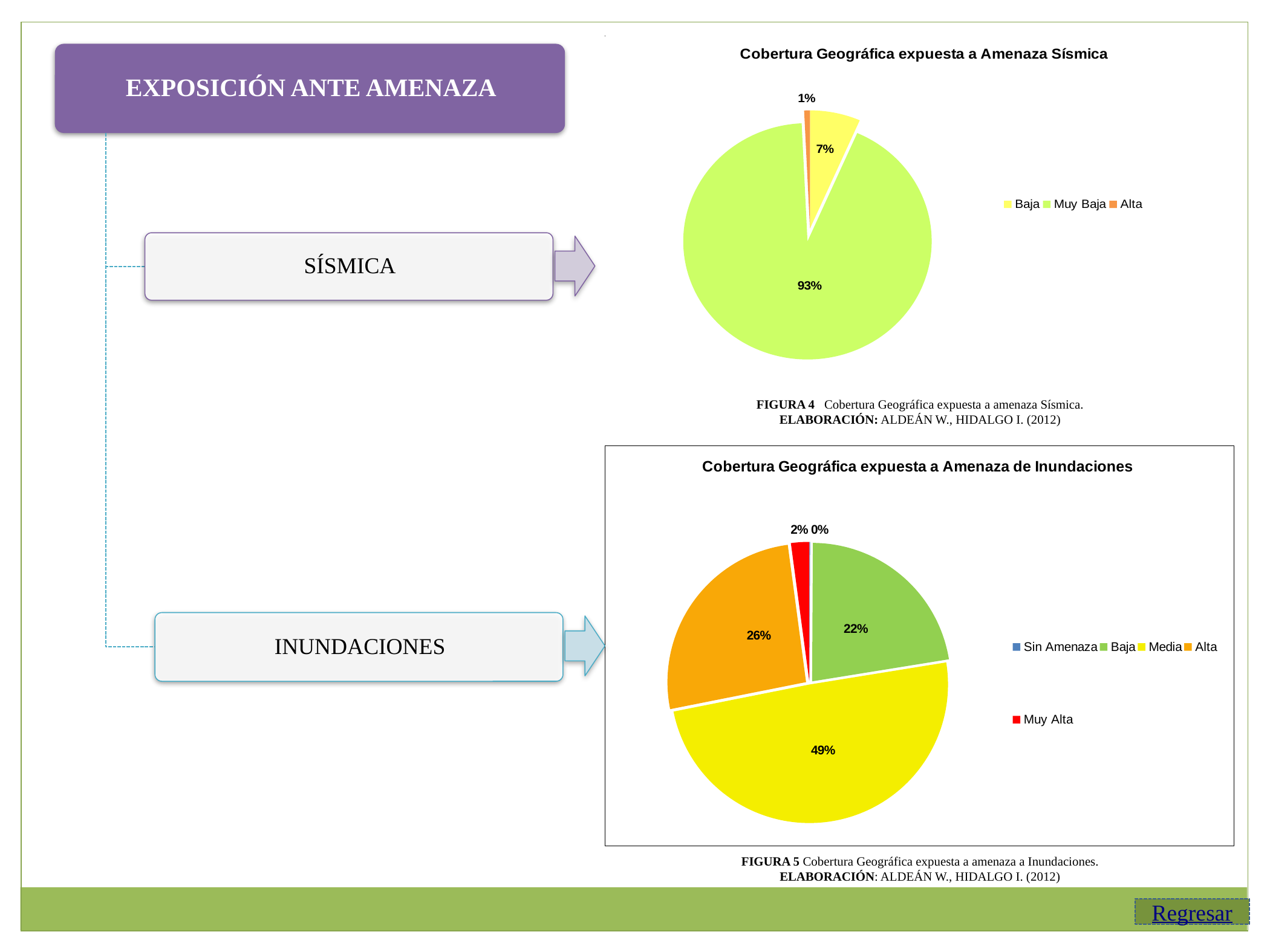
How many categories does the legend of the 'Cobertura Geográfica expuesta a Amenaza Sísmica' chart list? 3 In the 'Cobertura Geográfica expuesta a Amenaza de Inundaciones' chart, what share does Media have? 49% In the 'Cobertura Geográfica expuesta a Amenaza de Inundaciones' chart, what colour is the Muy Alta slice? Red In the 'Cobertura Geográfica expuesta a Amenaza de Inundaciones' chart, what share does Alta have? 26% In the 'Cobertura Geográfica expuesta a Amenaza Sísmica' chart, which category has the smallest slice? Alta In the 'Cobertura Geográfica expuesta a Amenaza Sísmica' chart, what share does Baja have? 7% In the 'Cobertura Geográfica expuesta a Amenaza de Inundaciones' chart, which category has the largest slice? Media What kind of chart is 'Cobertura Geográfica expuesta a Amenaza Sísmica'? Pie chart In the 'Cobertura Geográfica expuesta a Amenaza de Inundaciones' chart, which is larger, Baja or Alta? Alta In the 'Cobertura Geográfica expuesta a Amenaza de Inundaciones' chart, what is the difference between the Media and Baja shares? 27% How many categories does the legend of the 'Cobertura Geográfica expuesta a Amenaza de Inundaciones' chart list? 5